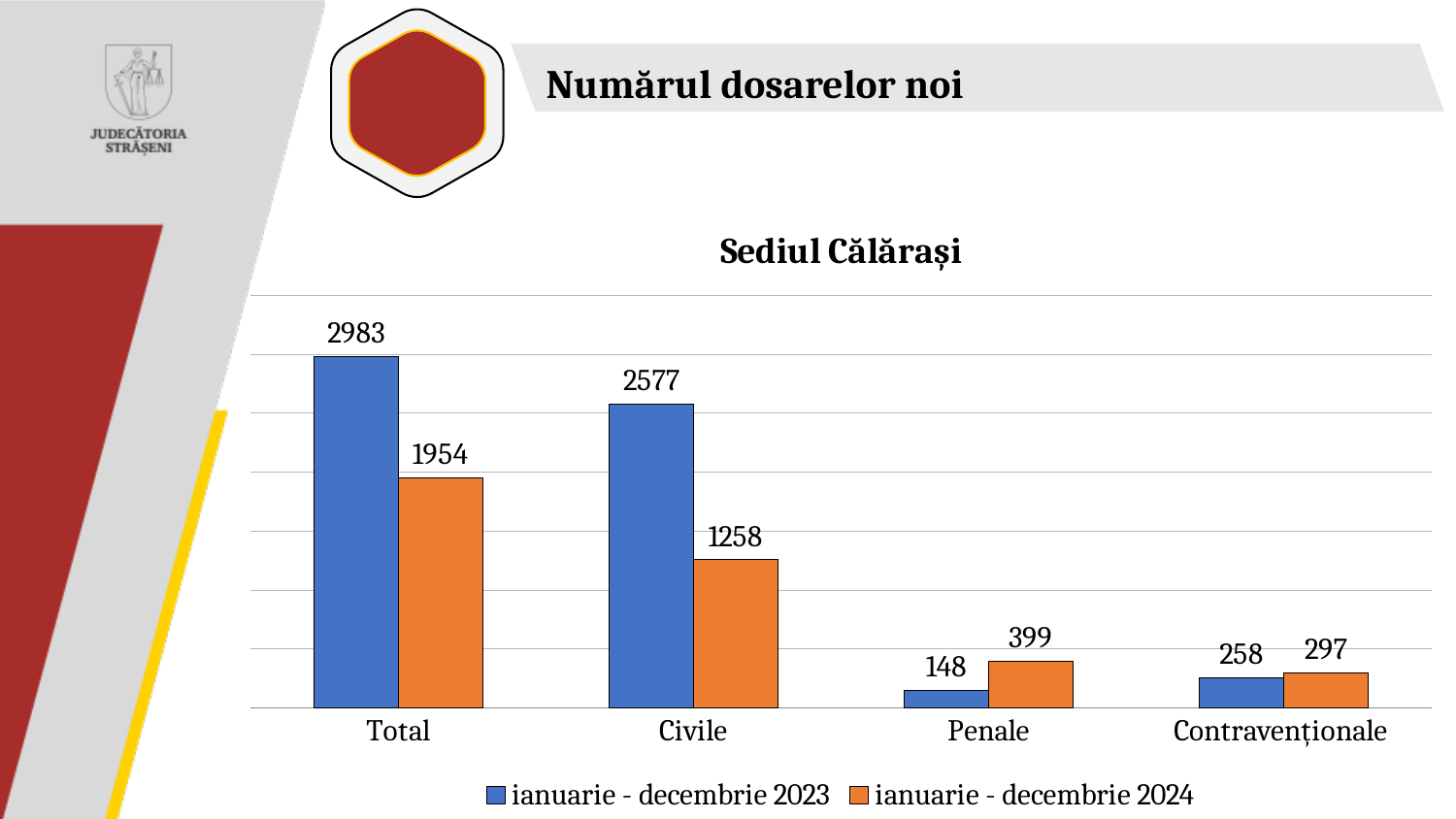
What is the value for Total in the ianuarie - decembrie 2023 series? 2983 How many series does the legend list? 2 What is the value for Contravenționale in the ianuarie - decembrie 2024 series? 297 What is the difference between the Penale values for ianuarie - decembrie 2024 and ianuarie - decembrie 2023? 251 How many categories are shown on the x axis? 4 What is the difference between the Total values for ianuarie - decembrie 2023 and ianuarie - decembrie 2024? 1029 Which category has the highest value in the ianuarie - decembrie 2024 series? Total What kind of chart is shown on the slide? Bar chart What is the value for Civile in the ianuarie - decembrie 2024 series? 1258 Which category has the lowest value in the ianuarie - decembrie 2023 series? Penale Which is larger for Civile: the ianuarie - decembrie 2023 value or the ianuarie - decembrie 2024 value? ianuarie - decembrie 2023 What is the value for Penale in the ianuarie - decembrie 2023 series? 148